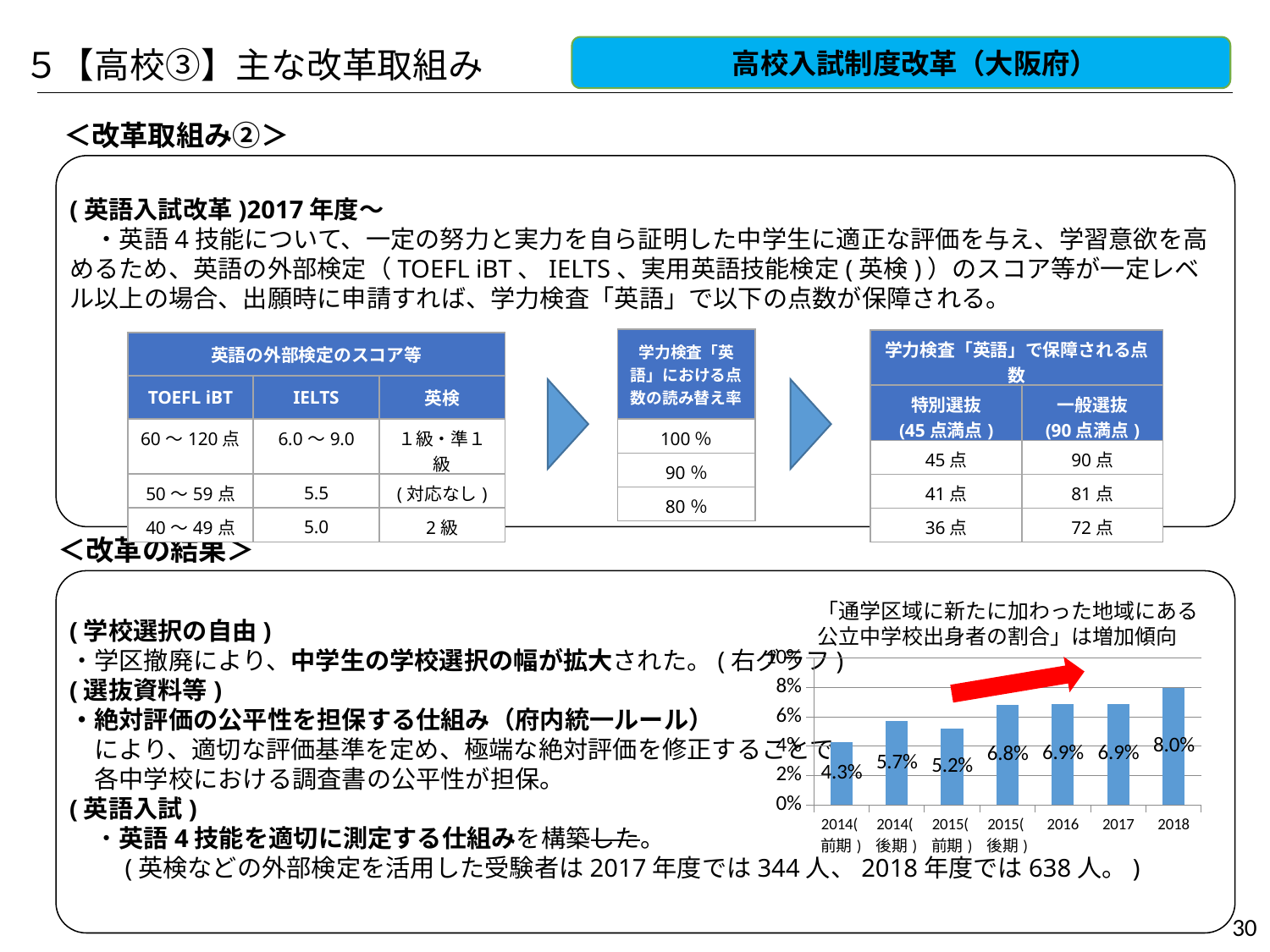
What is the value for 2014(前期) in the bar chart? 4.3% How many categories are shown on the x axis of the bar chart? 7 What is the difference between the values for 2018 and 2014(前期) in the bar chart? 3.7% What is the value for 2018 in the bar chart? 8.0% What is the value for 2015(後期) in the bar chart? 6.8% What is the value for 2014(後期) in the bar chart? 5.7% Do the values in the bar chart generally rise or fall from 2014(前期) to 2018? rise Is the value for 2016 in the bar chart greater or less than 6%? greater What kind of chart is shown on the slide? bar chart Which is larger in the bar chart, the value for 2014(後期) or the value for 2015(前期)? 2014(後期) Which category has the lowest value in the bar chart? 2014(前期) Which category has the highest value in the bar chart? 2018